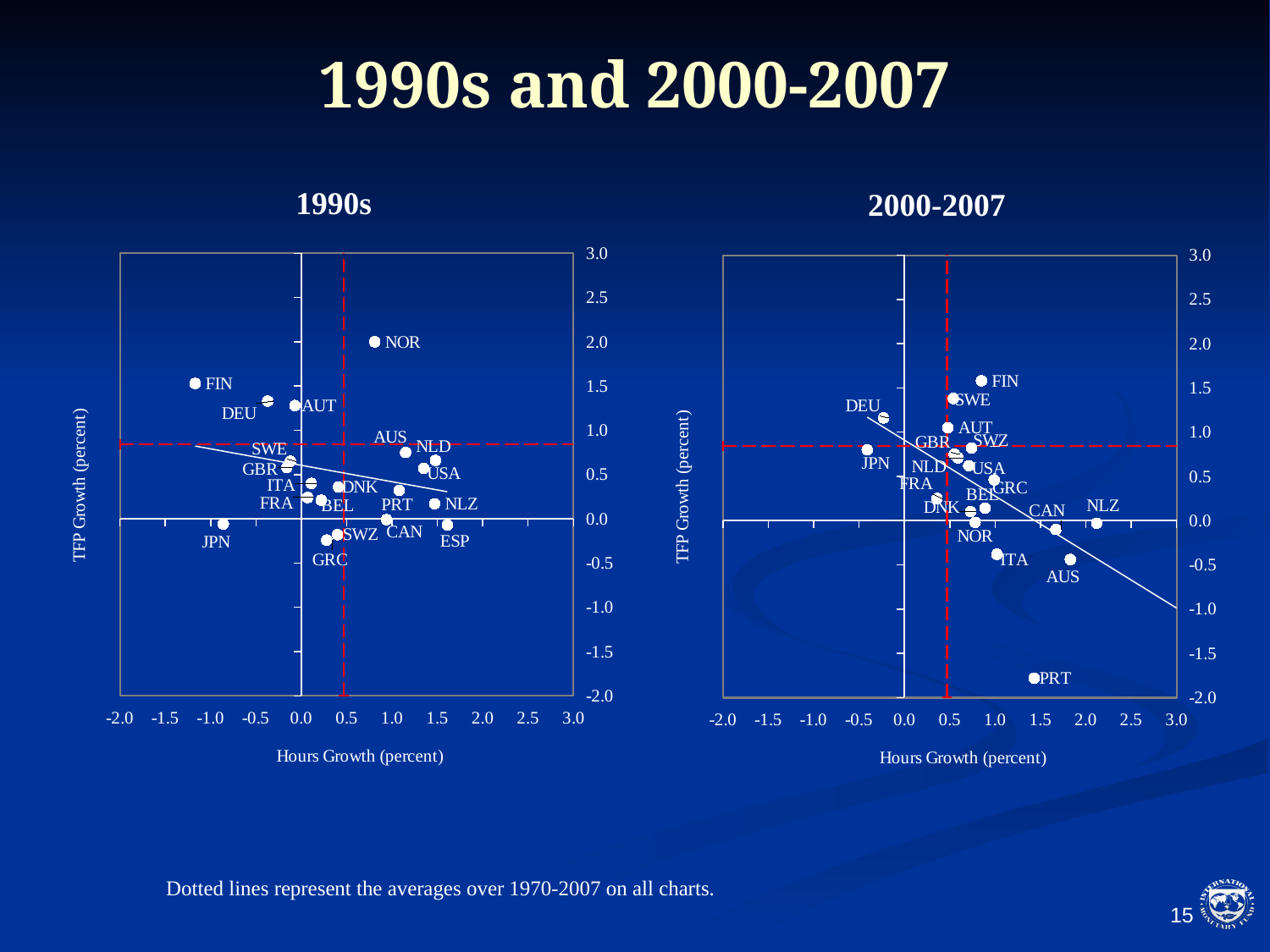
What kind of chart is the 1990s chart? scatter chart In the 2000-2007 chart, is the TFP growth for FIN greater or less than 1.0? greater In the 2000-2007 chart, which country has the lowest TFP growth? PRT In the 1990s chart, is the hours growth for JPN greater or less than -0.5? less In the 1990s chart, which country has the highest TFP growth? NOR In the 2000-2007 chart, is the TFP growth for PRT greater or less than -1.5? less In the 2000-2007 chart, which has the higher TFP growth, AUS or PRT? AUS In the 1990s chart, which country has the lowest hours growth? FIN In the 1990s chart, which country has the lowest TFP growth? GRC What is the x-axis label on the 2000-2007 chart? Hours Growth (percent)